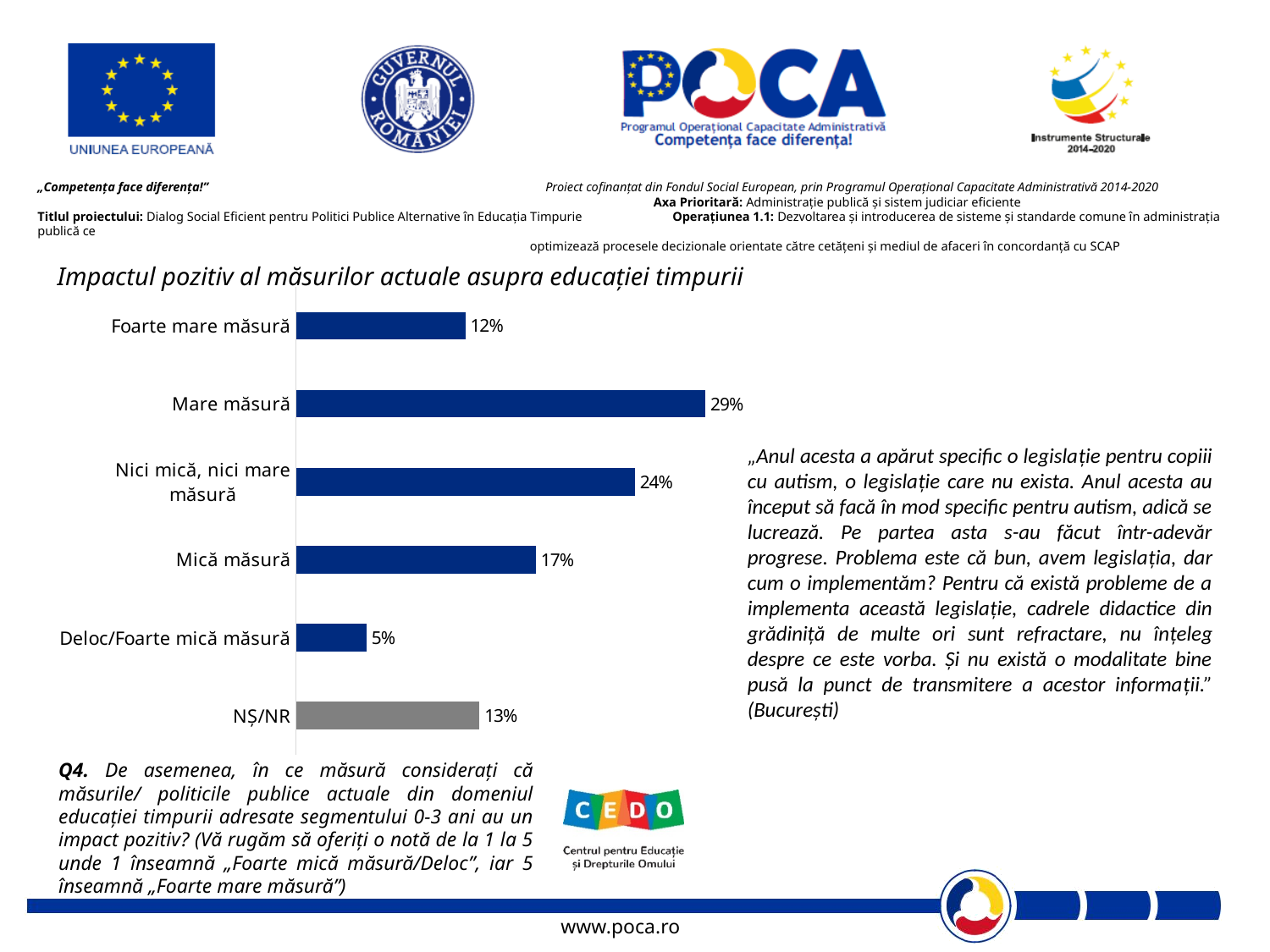
What value is shown for "Deloc/Foarte mică măsură"? 5% What value is shown for "Nici mică, nici mare măsură"? 24% Which category has the lowest value in the chart? Deloc/Foarte mică măsură What is the title of the chart? Impactul pozitiv al măsurilor actuale asupra educației timpurii How many categories are shown in the chart? 6 What percentage is shown for "NȘ/NR"? 13% What percentage of respondents answered "Mare măsură"? 29% Which category has the highest value in the chart? Mare măsură Which is larger: the value for "NȘ/NR" or the value for "Foarte mare măsură"? NȘ/NR What is the difference between the values for "Mare măsură" and "Mică măsură"? 12% What is the difference between the values for "Foarte mare măsură" and "Deloc/Foarte mică măsură"? 7% What type of chart is shown on the slide? Bar chart